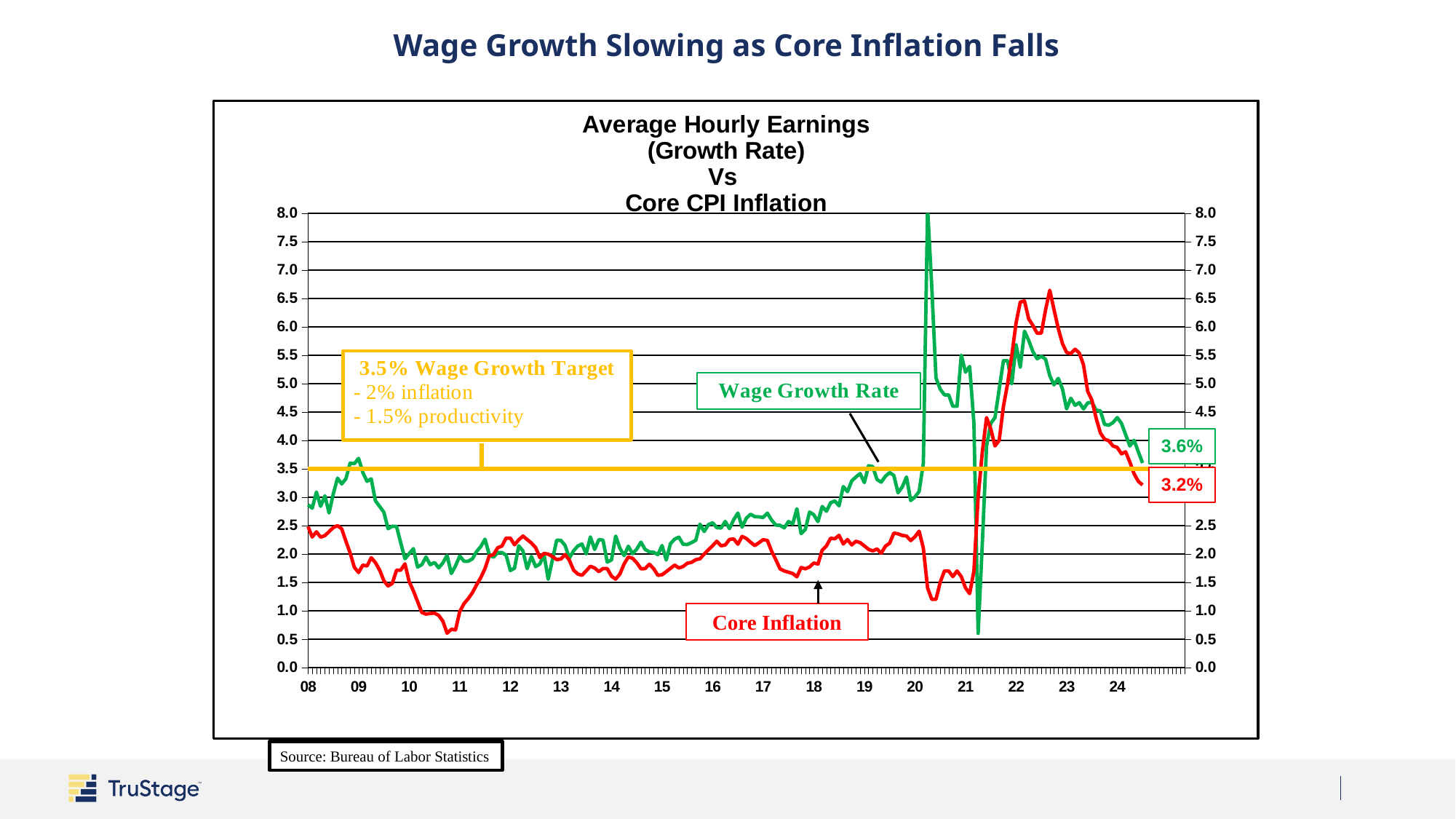
What is the latest labelled value of the Wage Growth Rate series? 3.6% Is the peak of the Wage Growth Rate line around 2020 greater or less than 7.0? greater What two components make up the 3.5% Wage Growth Target according to the annotation box? 2% inflation and 1.5% productivity What is the difference between the latest labelled Wage Growth Rate (3.6%) and the latest labelled Core Inflation (3.2%)? 0.4% Is the lowest point of the Core Inflation line around 2010-2011 greater or less than 1.0? less What is the latest labelled value of the Core Inflation series? 3.2% Does the Wage Growth Rate line rise or fall from 2022 to 2024? fall At what level is the horizontal Wage Growth Target line drawn? 3.5% How many data series are plotted on the chart (excluding the target line)? 2 Which is higher at the end of the series, the labelled Wage Growth Rate or the labelled Core Inflation? Wage Growth Rate Is the peak of the Core Inflation line in 2022 greater or less than 6.0? greater What kind of chart is shown on the slide? line chart